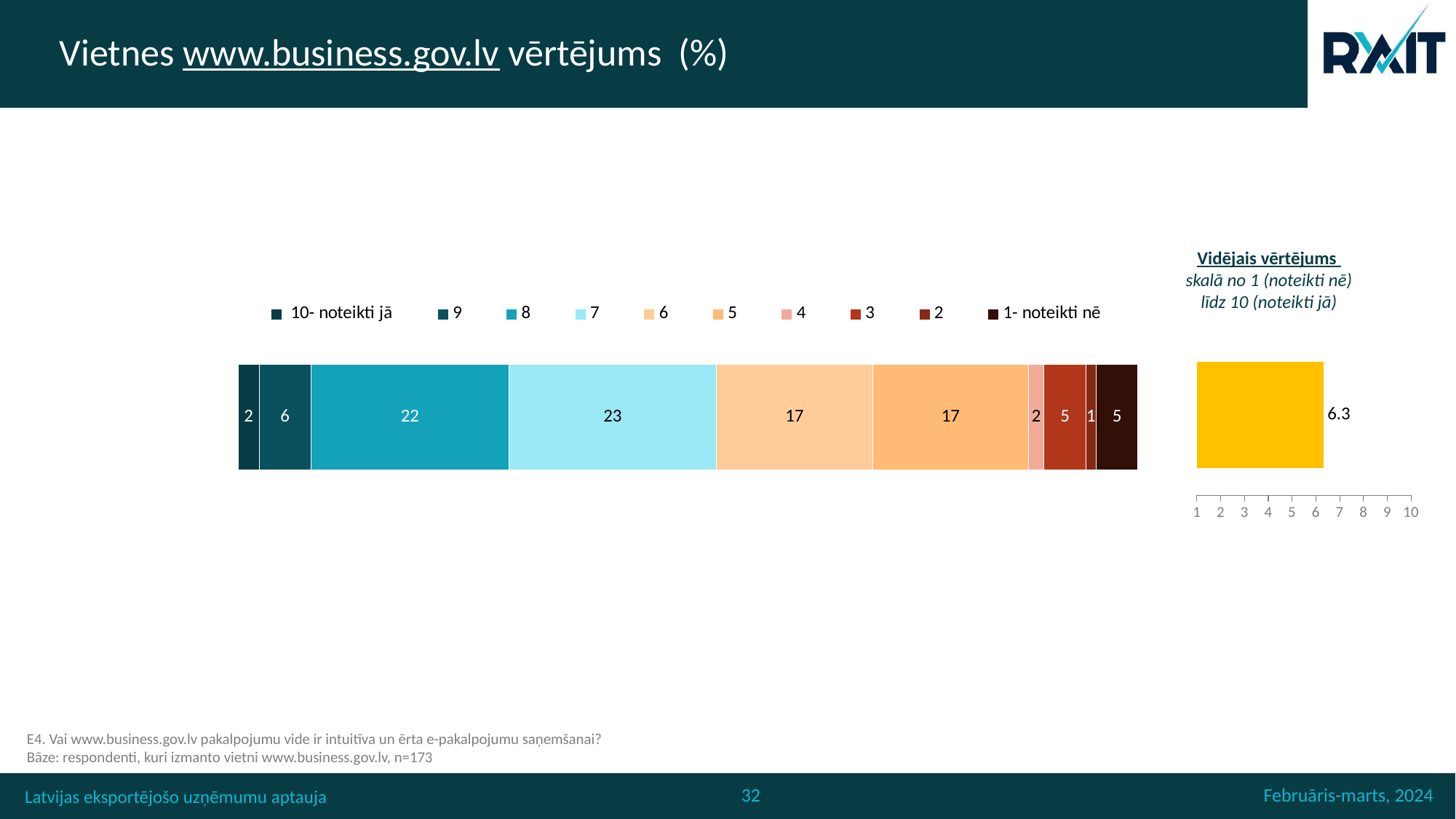
In the stacked bar chart, what is the total of all segments in the bar? 100 In the stacked bar chart, which is larger: the share for rating 3 or the share for rating 4? rating 3 In the stacked bar chart, what percentage of respondents chose '10- noteikti jā'? 2 In the stacked bar chart, which rating has the largest share of respondents? 7 In the stacked bar chart, what percentage of respondents chose '1- noteikti nē'? 5 In the 'Vidējais vērtējums' chart on the right, what is the average rating shown? 6.3 In the stacked bar chart, what percentage of respondents gave a rating of 7? 23 In the stacked bar chart, which rating has the smallest share of respondents? 2 How many series does the legend of the stacked bar chart list? 10 In the stacked bar chart, what is the difference between the share for rating 7 and the share for rating 9? 17 What kind of chart is the main chart on the slide? stacked bar chart In the stacked bar chart, what percentage of respondents gave a rating of 8? 22